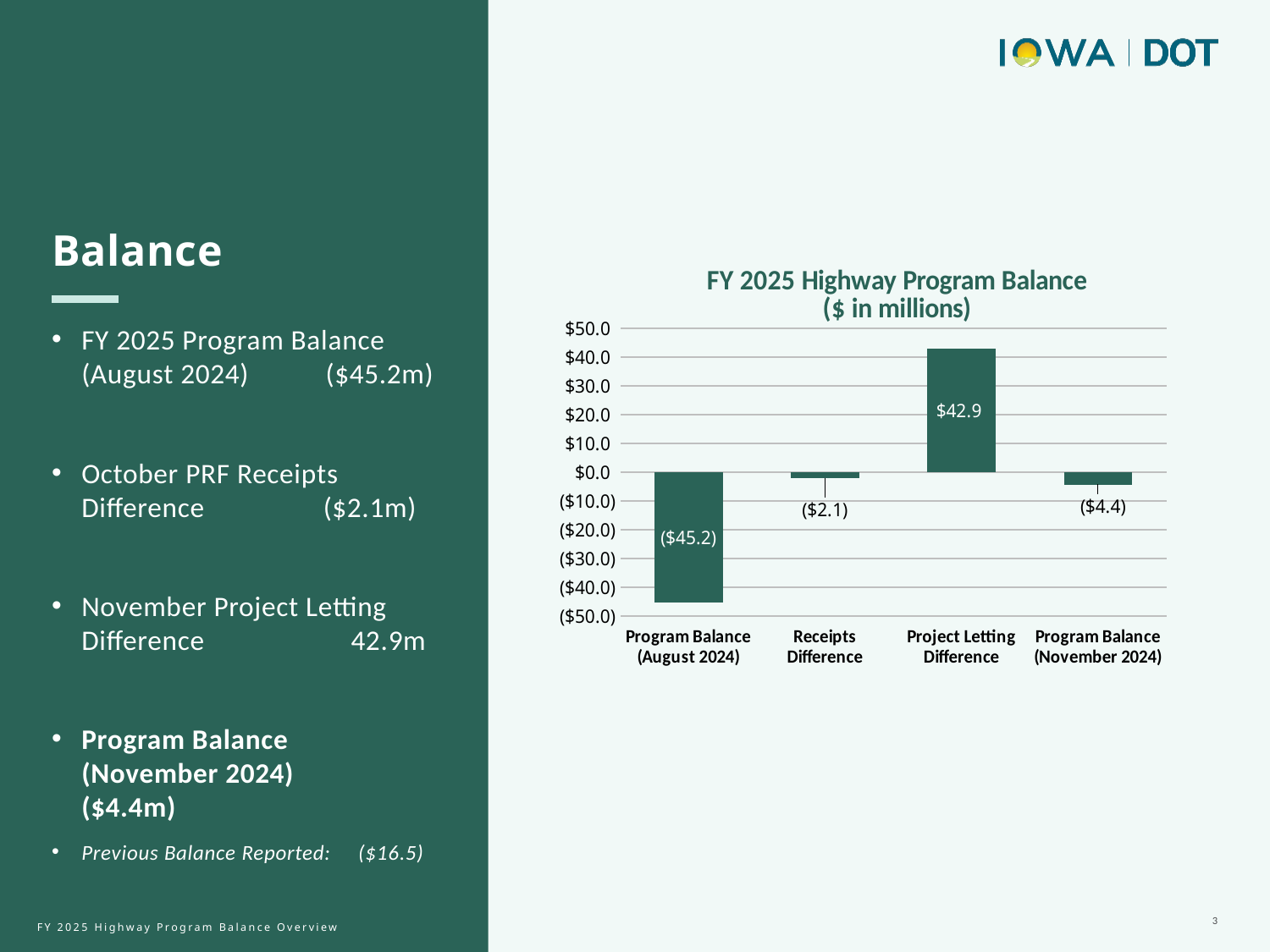
How many categories are shown on the x axis? 4 Is the value for Project Letting Difference greater or less than $40.0? greater What is the value for Program Balance (November 2024)? ($4.4) What is the value for Project Letting Difference? $42.9 Which category has the highest value? Project Letting Difference What kind of chart is shown? bar chart What is the value for Receipts Difference? ($2.1) What is the title of the chart? FY 2025 Highway Program Balance ($ in millions) How many of the bars extend below $0.0? 3 Which is larger, the value for Receipts Difference or the value for Program Balance (November 2024)? Receipts Difference What is the value for Program Balance (August 2024)? ($45.2) Which category has the lowest value? Program Balance (August 2024)